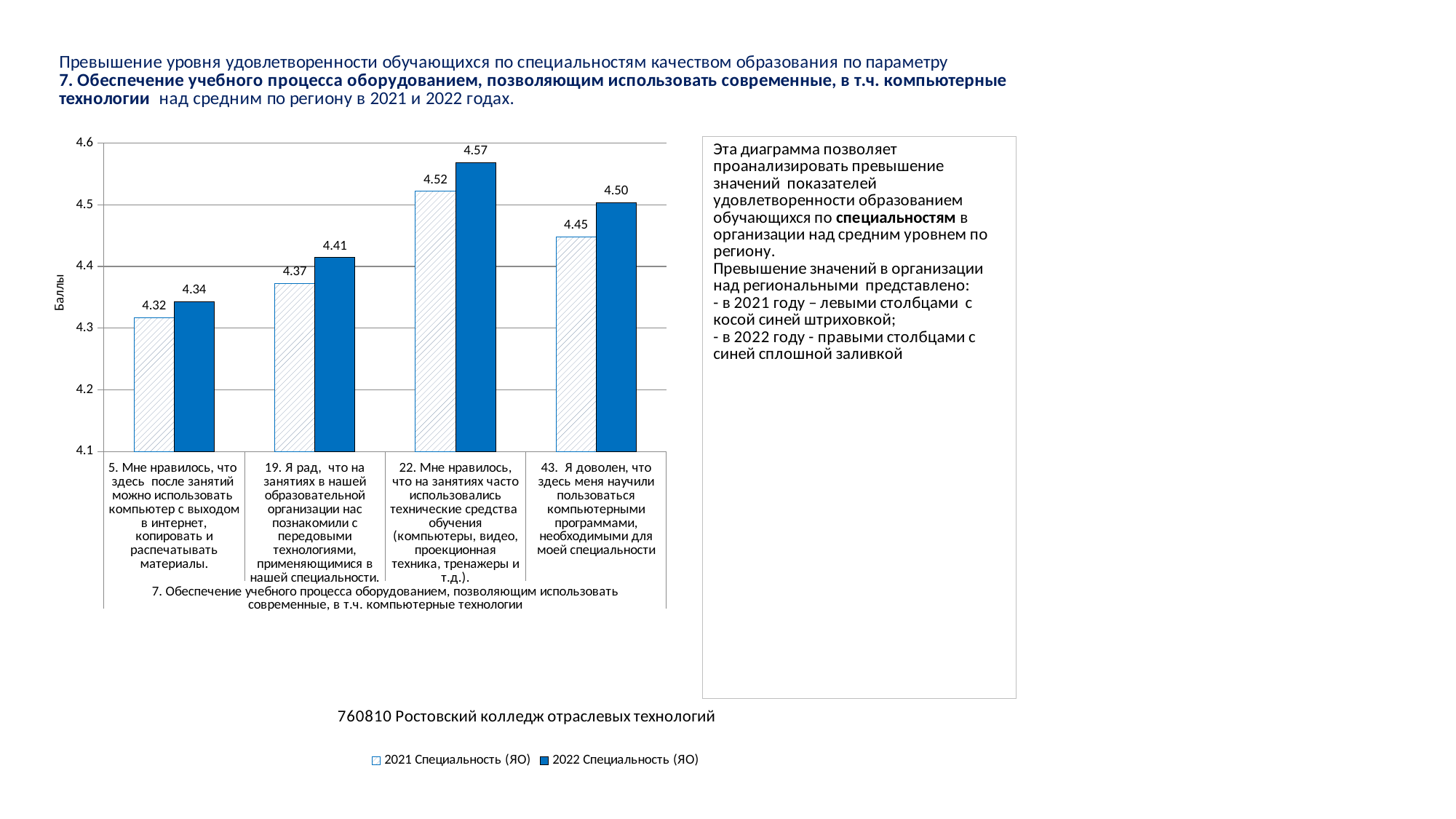
What is the difference between the 2022 and 2021 values for statement 19 (introduced to advanced technologies in our specialty)? 0.04 What type of chart is shown on the slide? Bar chart Which statement has the highest value in the 2021 Специальность (ЯО) series? 22. Мне нравилось, что на занятиях часто использовались технические средства обучения How many statements (categories) are shown on the x axis of the chart? 4 Which statement has the lowest value in the 2022 Специальность (ЯО) series? 5. Мне нравилось, что здесь после занятий можно использовать компьютер с выходом в интернет What is the value for the 2021 Специальность (ЯО) series for statement 5 (using a computer with internet access after classes)? 4.32 How many series does the chart legend list? 2 What is the value for the 2022 Специальность (ЯО) series for statement 22 (technical teaching aids were often used in classes)? 4.57 What is the value for the 2022 Специальность (ЯО) series for statement 43 (taught to use computer programs needed for my specialty)? 4.50 What is the label of the vertical axis of the chart? Баллы Is the 2021 value for statement 22 greater or less than 4.5? greater Which is larger for statement 43: the 2021 value or the 2022 value? 2022 (4.50)